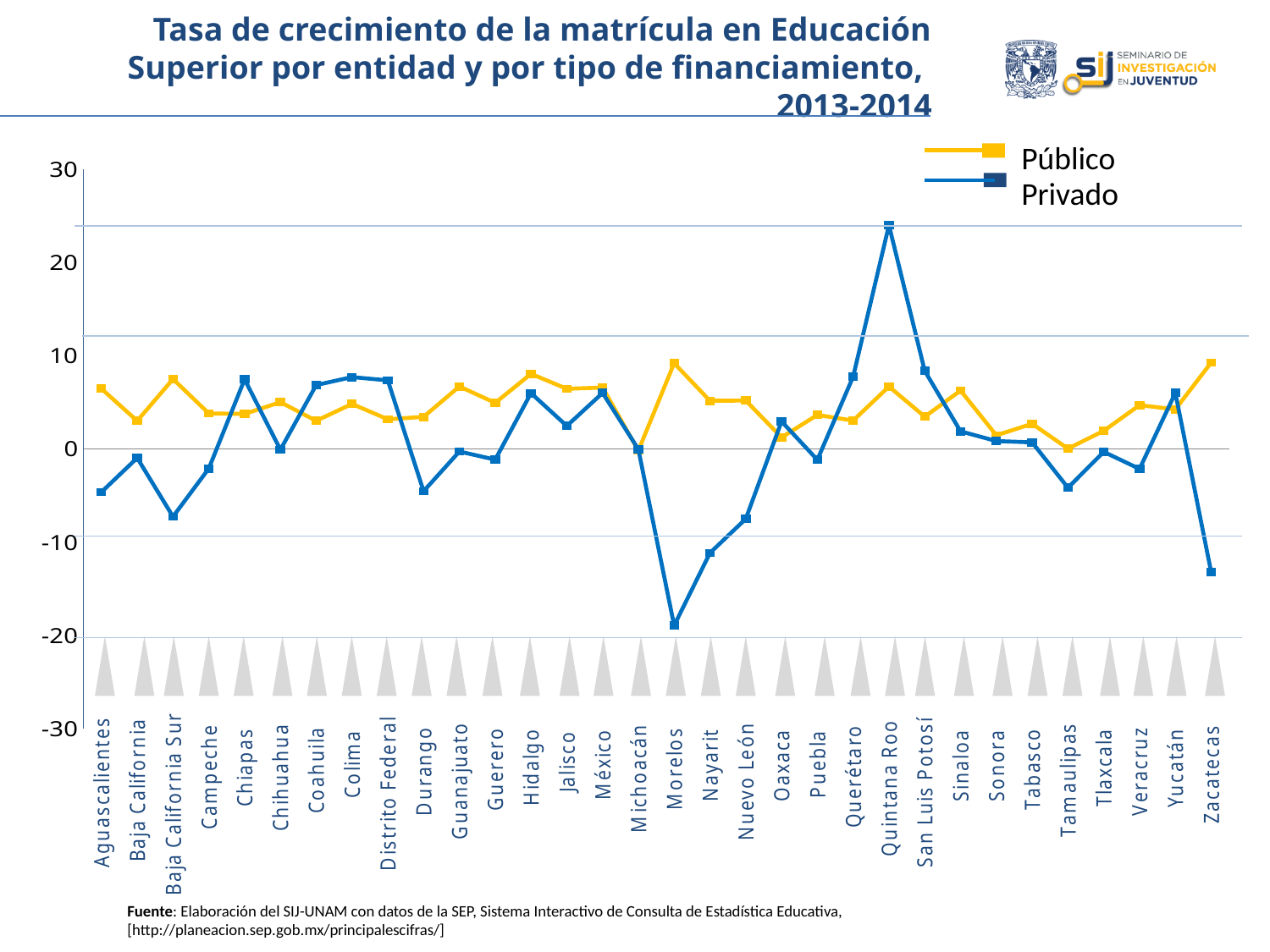
Which entity has the lowest value for the Privado series? Morelos How many entities (categories) are plotted along the x axis? 32 What kind of chart is shown on the slide? line chart Is the Privado value for Quintana Roo greater or less than 20? greater For Morelos, which series has the larger value, Público or Privado? Público Is the Privado value for Morelos greater or less than -10? less For Quintana Roo, which series has the larger value, Público or Privado? Privado Is the Privado value for Zacatecas greater or less than -10? less What are the two series named in the legend? Público and Privado How many series does the legend list? 2 Which entity has the highest value for the Privado series? Quintana Roo